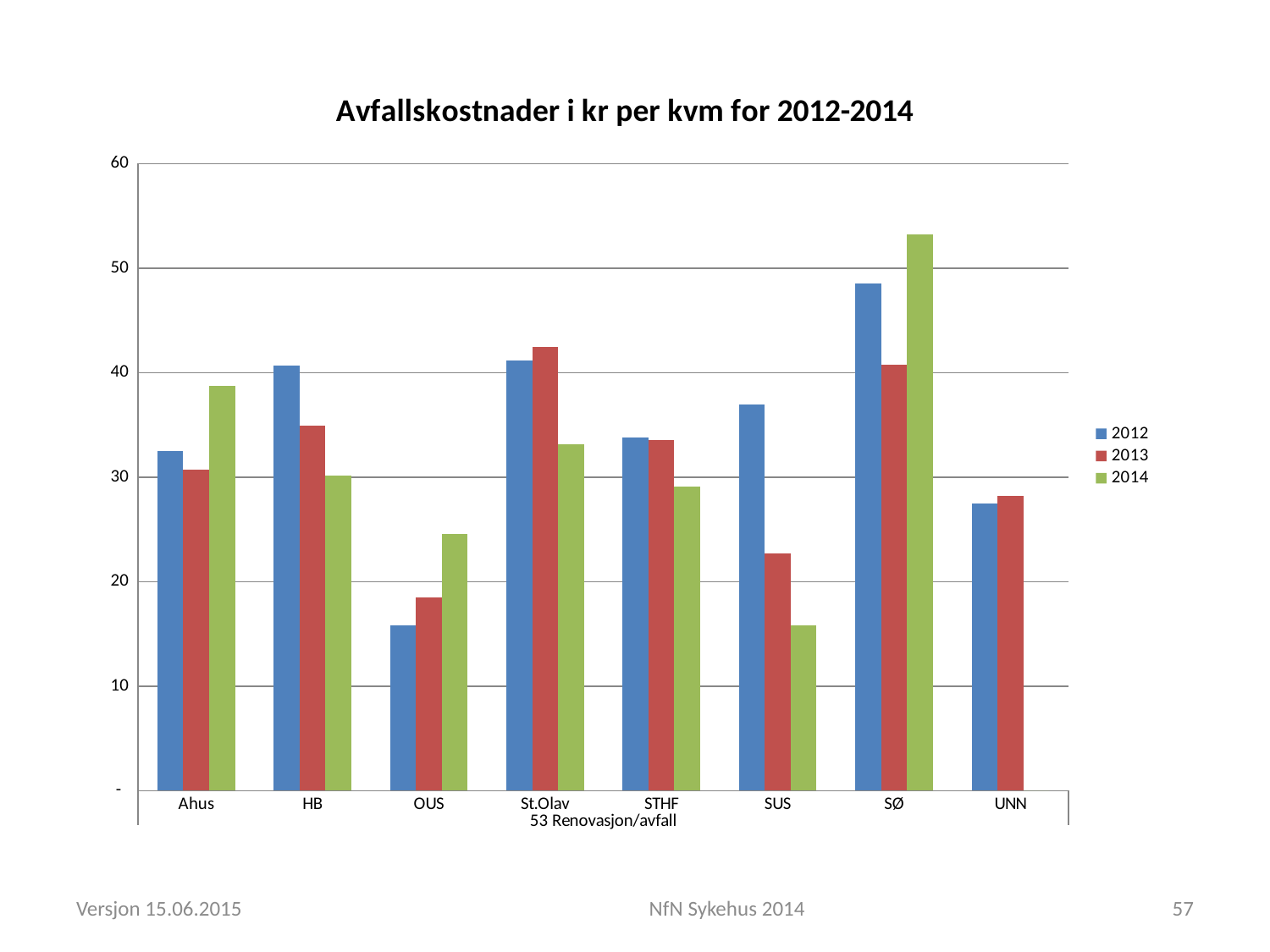
Which hospital has the lowest value for 2012? OUS Do the values for OUS rise or fall from 2012 to 2014? rise Is the 2014 value for SØ greater or less than 50? greater What kind of chart is shown on the slide? bar chart Which hospital has the lowest value for 2013? OUS For SUS, which year has the larger value, 2012 or 2013? 2012 Is the 2012 value for OUS greater or less than 20? less Which hospital has the highest value for 2012? SØ How many hospitals (categories) are shown on the x axis? 8 How many series does the legend list? 3 Which hospital has the highest value for 2014? SØ